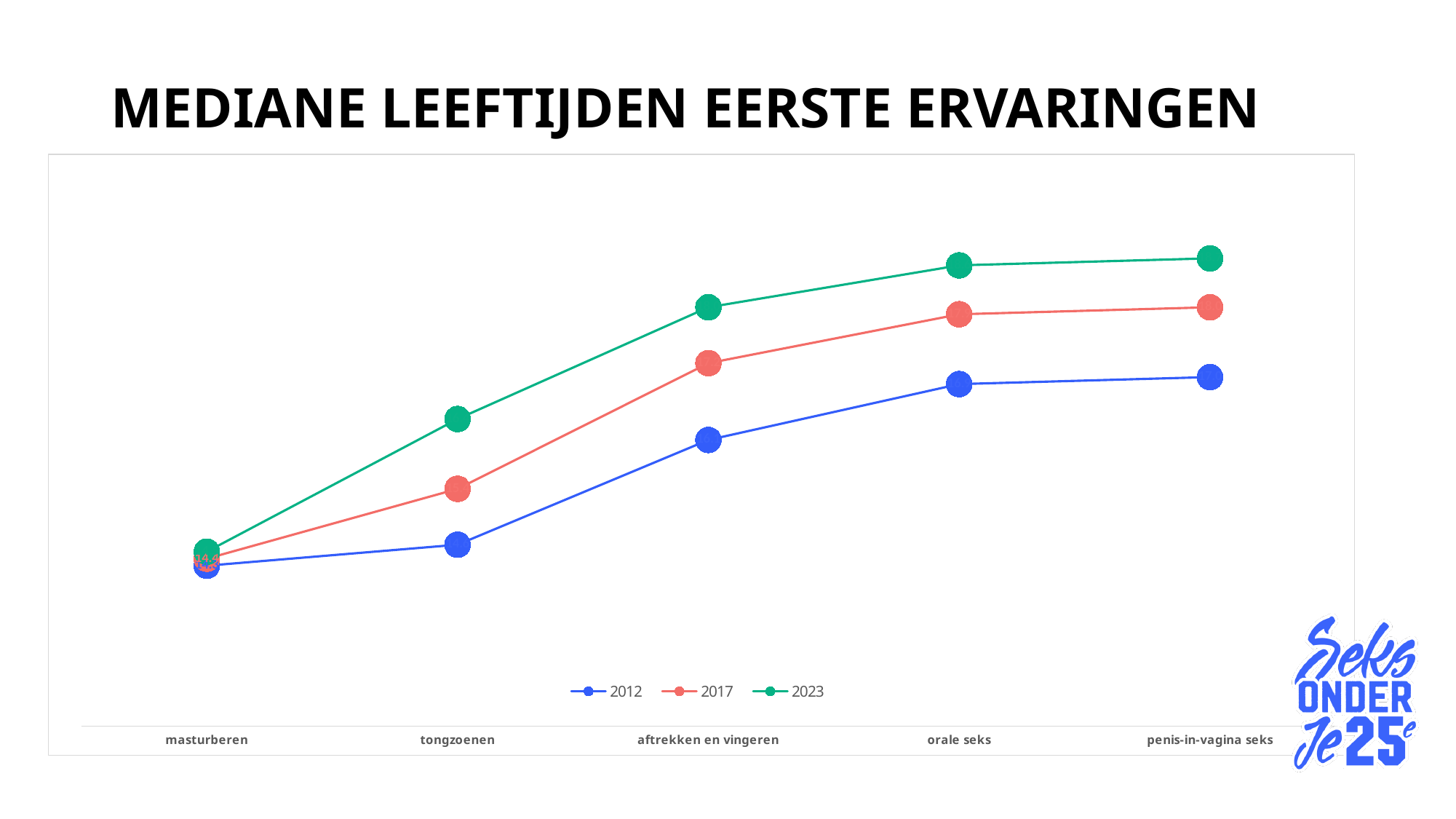
How many series does the legend list? 3 For orale seks, which series has the lower value, 2017 or 2023? 2017 For tongzoenen, which series has the higher value, 2012 or 2023? 2023 Which category has the lowest value for the 2017 series? masturberen Do the values for the 2023 series rise or fall from masturberen to penis-in-vagina seks? rise Which series are listed in the legend? 2012, 2017, 2023 Do the values for the 2012 series rise or fall along the x axis? rise For aftrekken en vingeren, which series has the higher value, 2017 or 2012? 2017 What kind of chart is shown on the slide? line chart What is the title of the chart? MEDIANE LEEFTIJDEN EERSTE ERVARINGEN Which category has the lowest value for the 2023 series? masturberen How many categories are shown on the x axis? 5